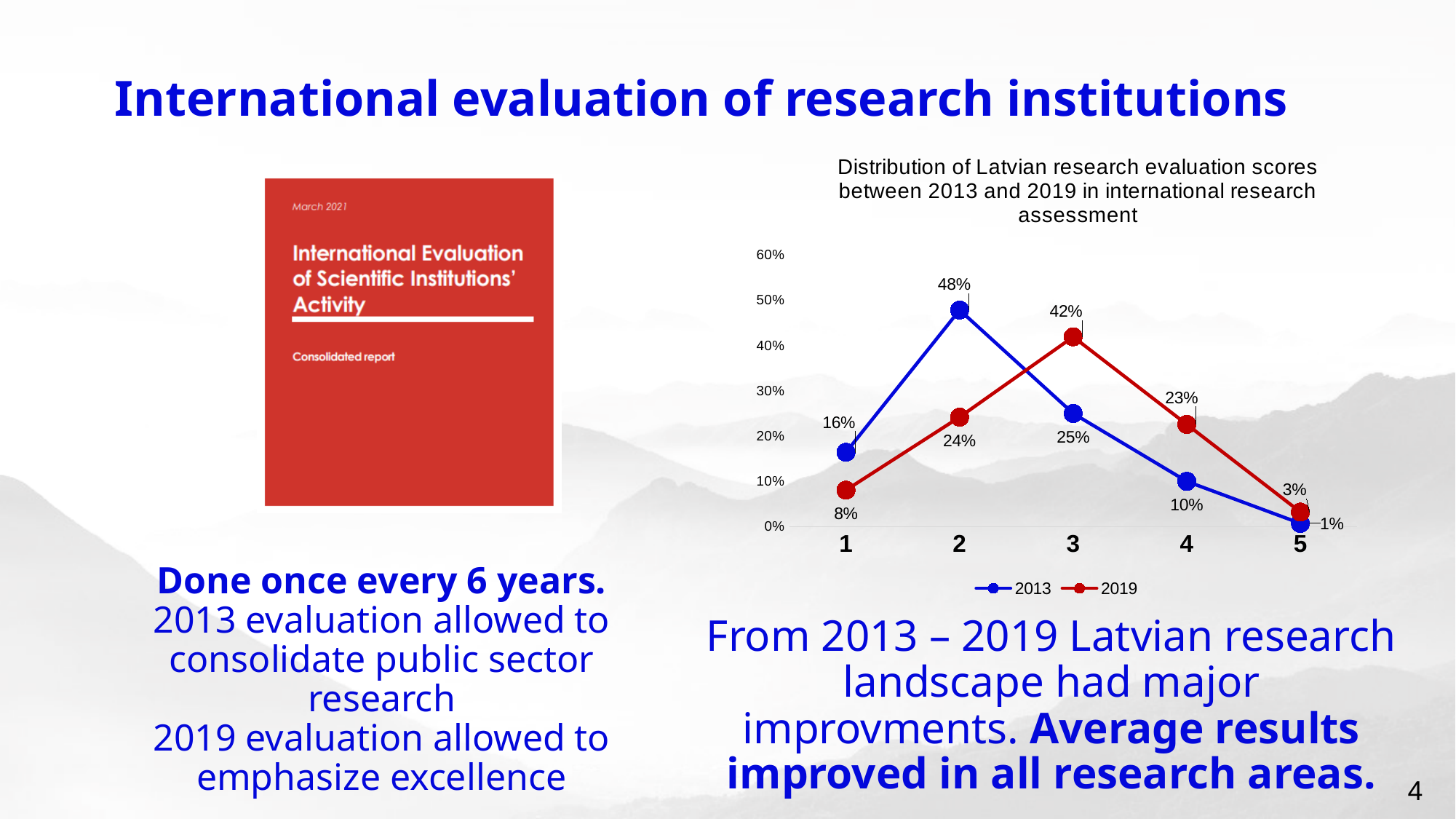
What is the value for score 5 in the 2013 series? 1% What is the value for score 2 in the 2013 series? 48% What is the value for score 3 in the 2019 series? 42% What is the difference between the 2013 and 2019 values for score 2? 24% Which score has the lowest value in the 2019 series? 5 Which colour represents the 2019 series in the chart? red What type of chart is shown on the slide? line chart What is the value for score 1 in the 2019 series? 8% How many score categories are shown on the x axis? 5 How many series does the legend list? 2 Which series has the larger value for score 4, 2013 or 2019? 2019 Which score has the highest value in the 2013 series? 2